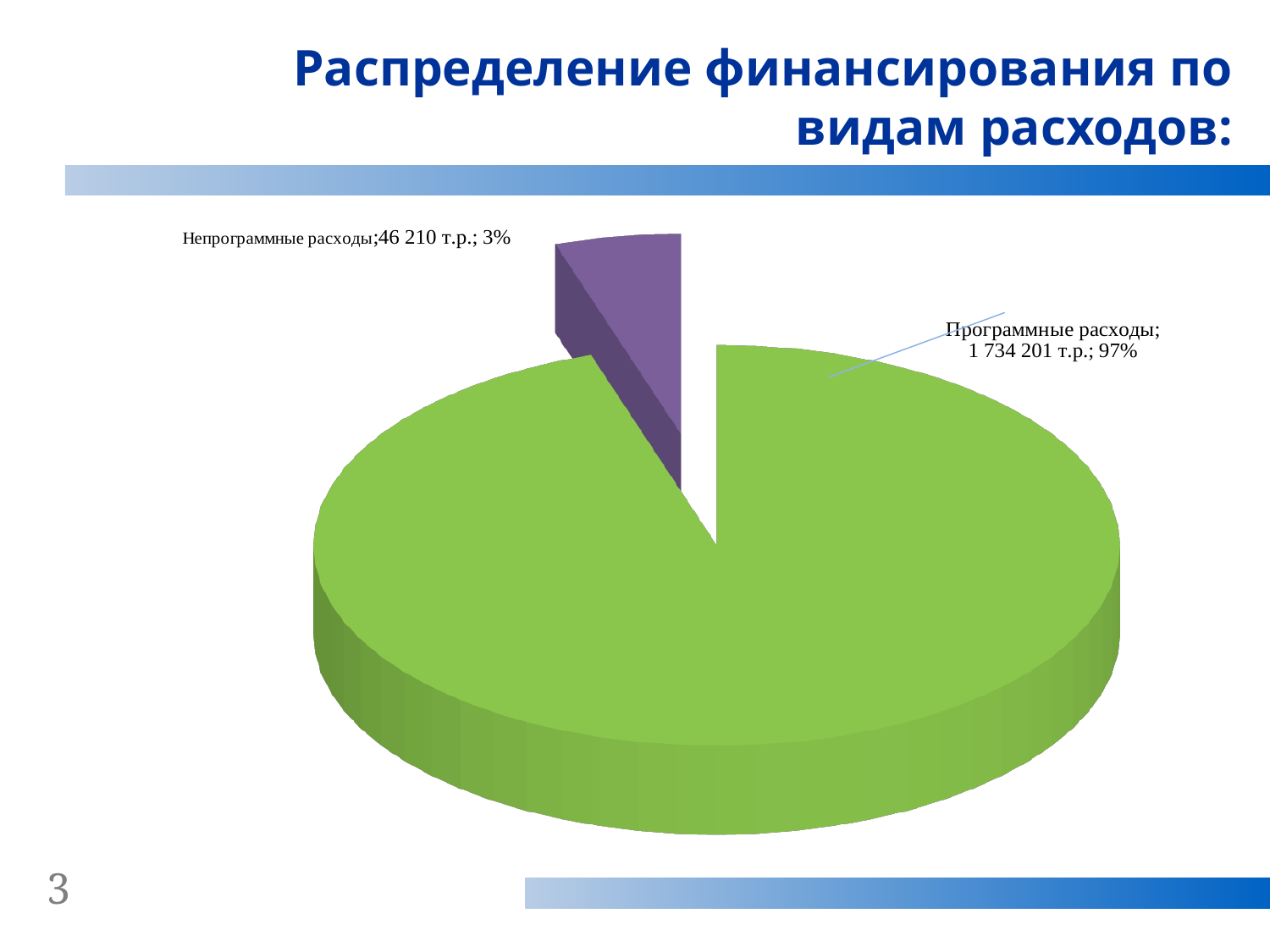
What share of the pie does Программные расходы represent? 97% Which category has the smallest slice of the pie? Непрограммные расходы What is the value for Программные расходы? 1 734 201 т.р. Which category has the largest slice of the pie? Программные расходы What colour is the slice for Непрограммные расходы? purple What kind of chart is shown on the slide? pie chart What is the value for Непрограммные расходы? 46 210 т.р. How many slices does the pie chart have? 2 Which is larger, Программные расходы or Непрограммные расходы? Программные расходы What share of the pie does Непрограммные расходы represent? 3% What is the difference between the values for Программные расходы and Непрограммные расходы? 1 687 991 т.р. What is the title of the slide containing the pie chart? Распределение финансирования по видам расходов: